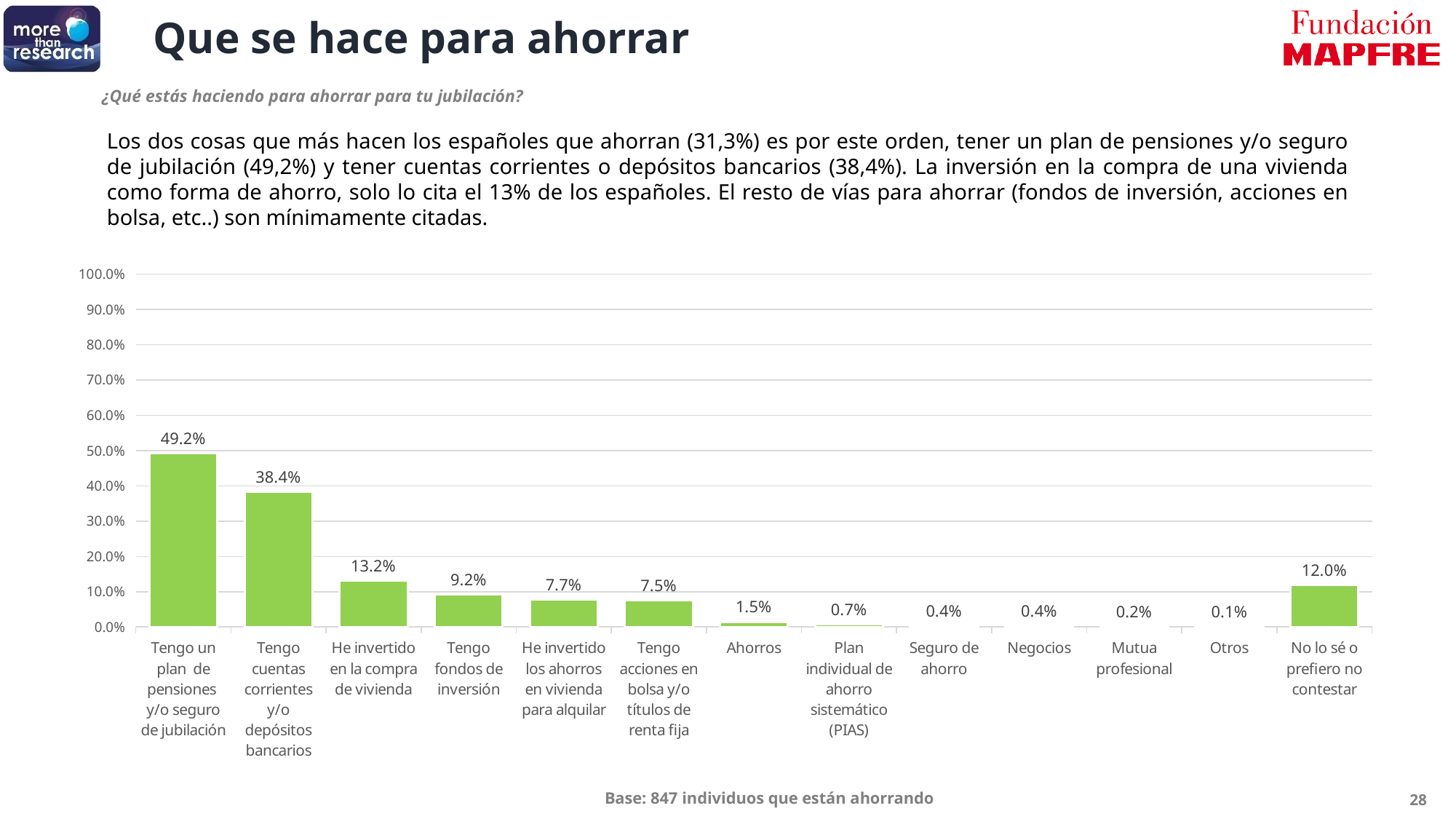
How many categories are shown on the x axis? 13 Which is larger: the value for "Tengo fondos de inversión" or the value for "No lo sé o prefiero no contestar"? No lo sé o prefiero no contestar What is the value for "No lo sé o prefiero no contestar"? 12.0% What kind of chart is shown on the slide? bar chart What is the base stated below the chart? 847 individuos que están ahorrando What is the value for "He invertido en la compra de vivienda"? 13.2% What is the difference between the values for "Tengo un plan de pensiones y/o seguro de jubilación" and "Tengo cuentas corrientes y/o depósitos bancarios"? 10.8% What is the value for "Tengo un plan de pensiones y/o seguro de jubilación"? 49.2% Is the value for "Tengo cuentas corrientes y/o depósitos bancarios" greater or less than 30.0%? greater Which category has the lowest value? Otros Which category has the highest value? Tengo un plan de pensiones y/o seguro de jubilación What is the value for "Tengo cuentas corrientes y/o depósitos bancarios"? 38.4%